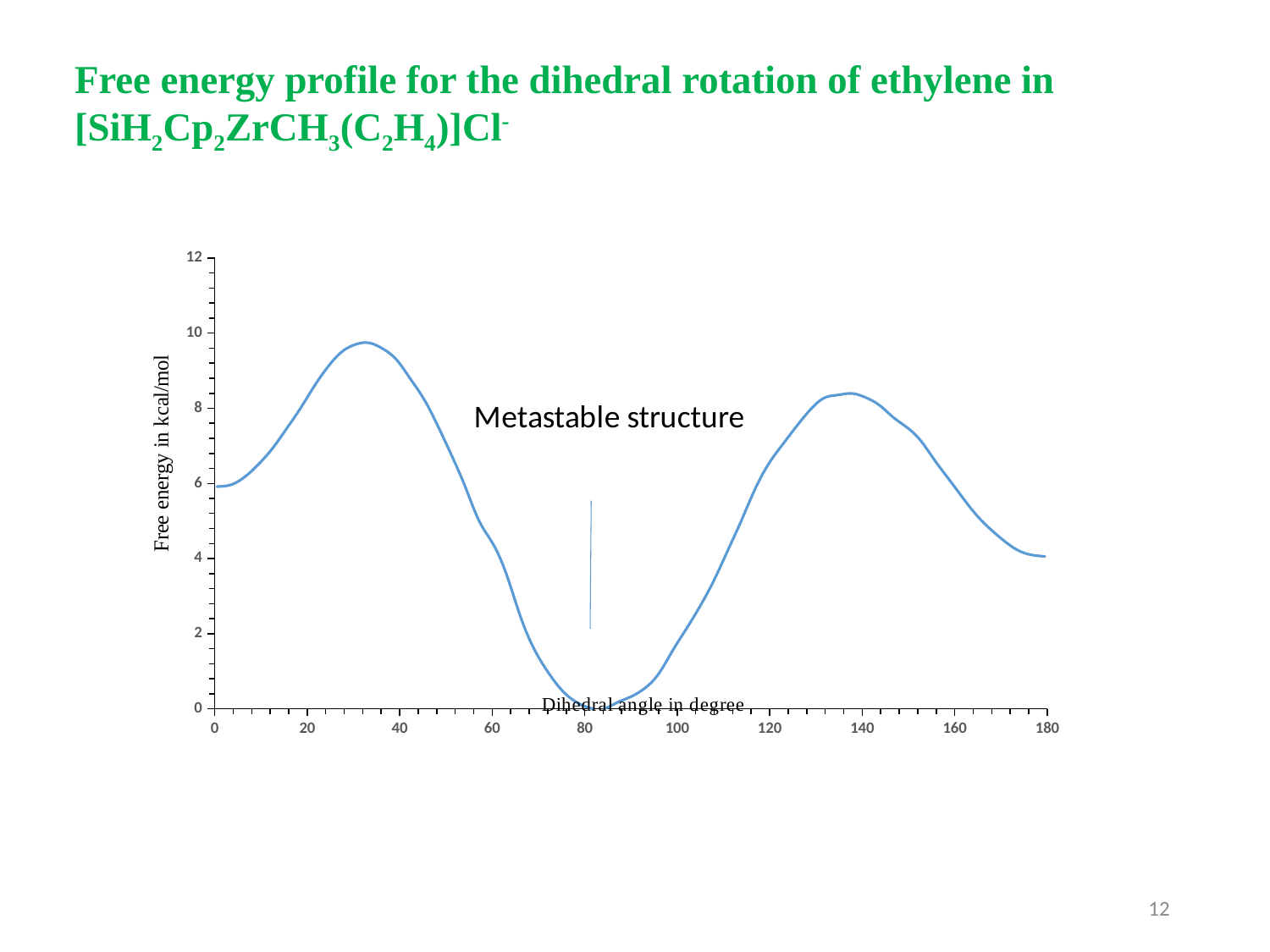
Is the free energy at a dihedral angle of 30 degrees greater or less than 8? greater Between dihedral angles of 40 and 80 degrees, does the free energy rise or fall? fall Which peak of the curve is higher, the one near 30 degrees or the one near 140 degrees? the one near 30 degrees What is the label of the y axis? Free energy in kcal/mol Near which x-axis tick value does the curve reach its lowest point? 80 Is the free energy at a dihedral angle of 180 degrees greater or less than 6? less What kind of chart is shown on the slide? line chart What text annotation is placed above the minimum of the curve? Metastable structure Is the free energy at a dihedral angle of 0 degrees greater or less than 4? greater Between dihedral angles of 80 and 140 degrees, does the free energy rise or fall? rise